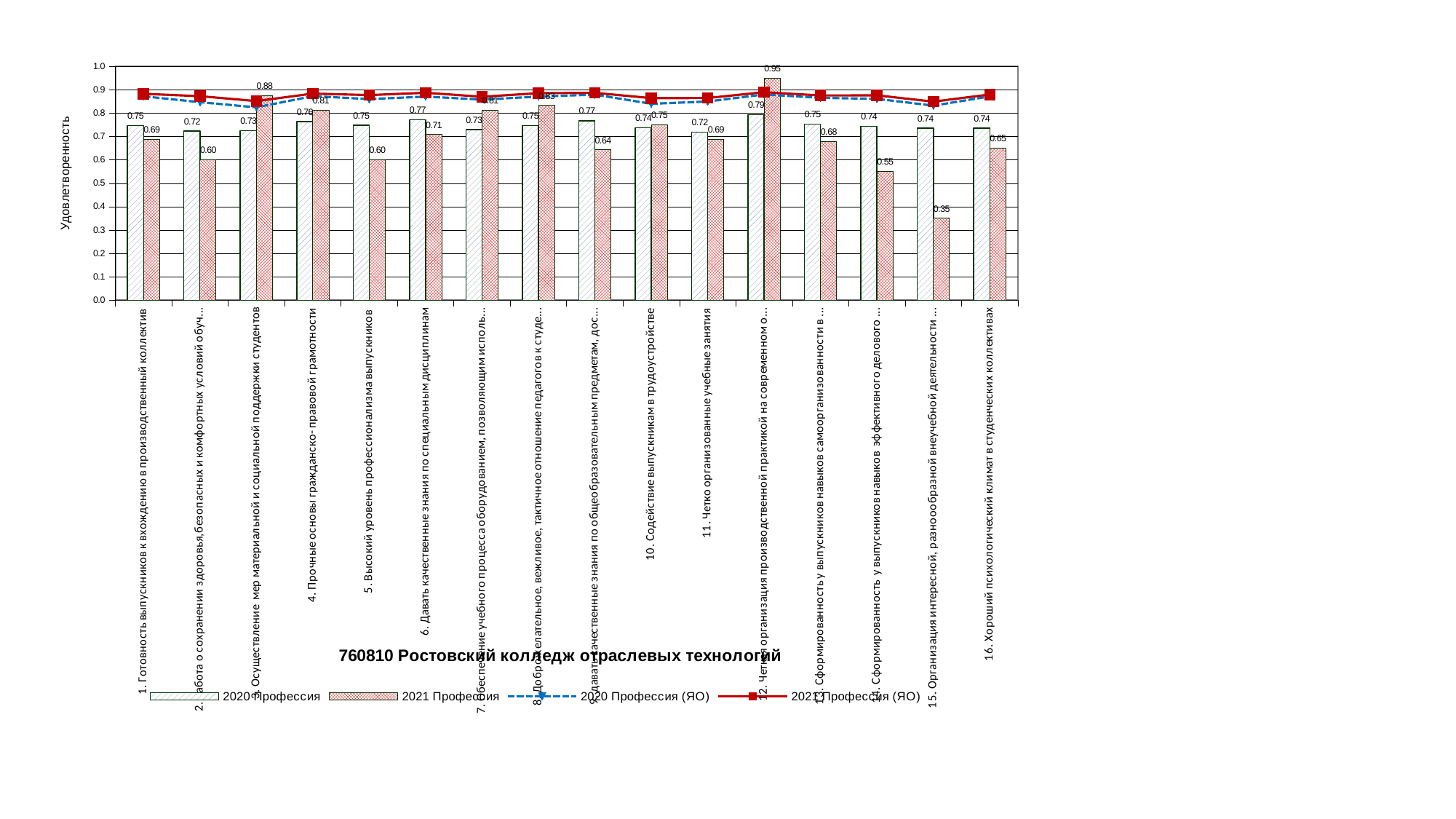
What is the title of the y axis? Удовлетворенность What is the 2021 Профессия value for "14. Сформированность у выпускников навыков эффективного делового ..."? 0.55 Which category has the highest 2021 Профессия value? 12. Четкая организация производственной практикой на современном о... (0.95) How many series does the legend list? 4 Which category has the highest 2020 Профессия value? 12. Четкая организация производственной практикой на современном о... (0.79) Is the 2021 Профессия (ЯО) line value for "1. Готовность выпускников к вхождению в производственный коллектив" greater or less than 0.8? greater What is the 2021 Профессия value for "16. Хороший психологический климат в студенческих коллективах"? 0.65 Which category has the lowest 2021 Профессия value? 15. Организация интересной, разнообразной внеучебной деятельности ... (0.35) What is the 2020 Профессия value for "5. Высокий уровень профессионализма выпускников"? 0.75 For "3. Осуществление мер материальной и социальной поддержки студентов", which is larger: the 2020 Профессия value or the 2021 Профессия value? 2021 Профессия How many categories are shown on the x axis? 16 What is the difference between the 2020 Профессия and 2021 Профессия values for "15. Организация интересной, разнообразной внеучебной деятельности ..."? 0.39